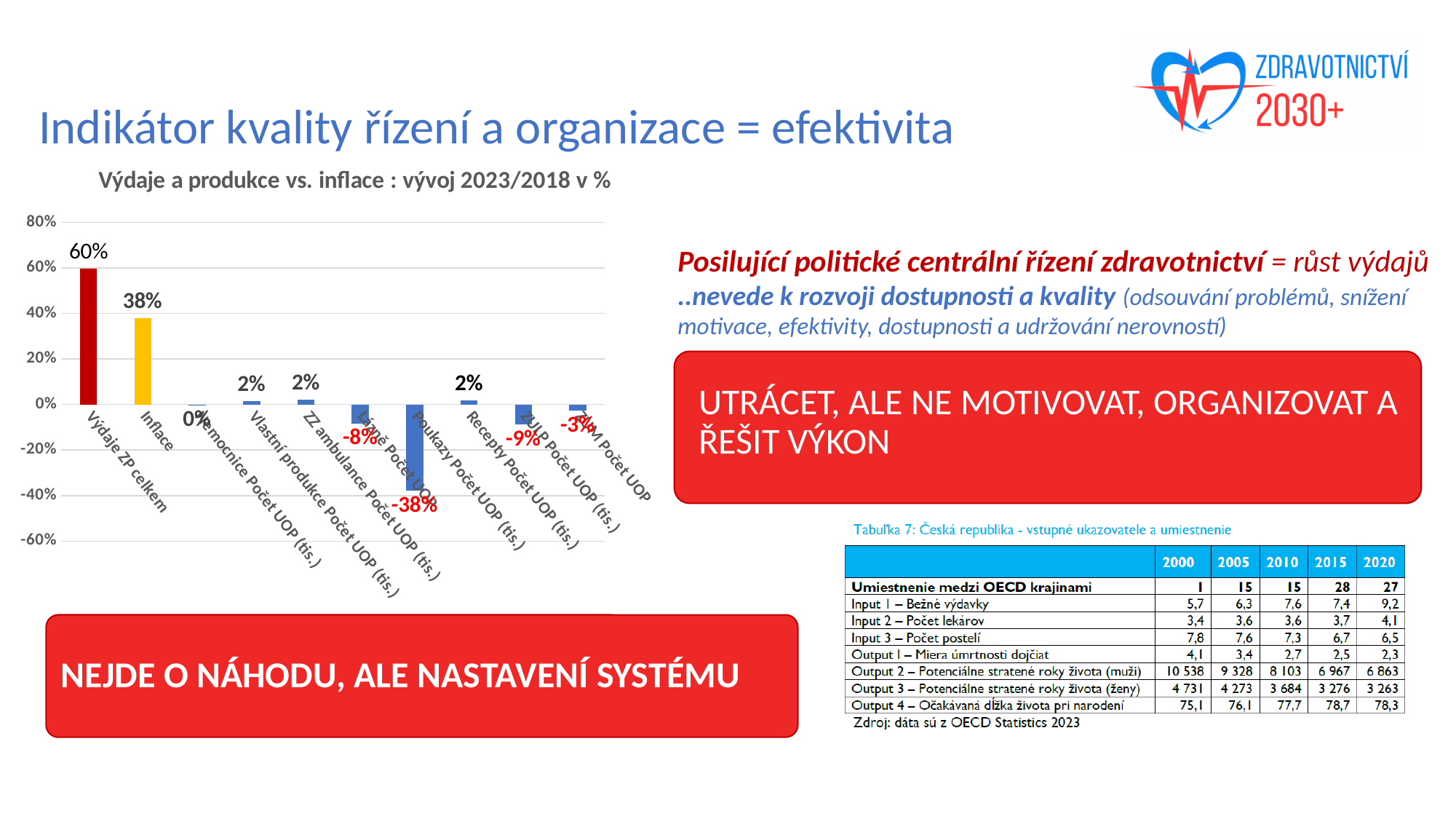
Which category has the lowest value? Poukazy Počet UOP (tis.) Which category has the highest value? Výdaje ZP celkem What kind of chart is shown on the slide? bar chart What is the title of the chart? Výdaje a produkce vs. inflace : vývoj 2023/2018 v % How many categories are shown in the chart? 10 What is the difference between the values for Výdaje ZP celkem and Inflace? 22% What is the value for Lázně Počet UOP? -8% What is the value for Výdaje ZP celkem? 60% Is the value for Výdaje ZP celkem greater or less than 40%? greater What is the value for Poukazy Počet UOP (tis.)? -38% What is the value for Inflace? 38% Which is larger, the value for Inflace or the value for Recepty Počet UOP (tis.)? Inflace